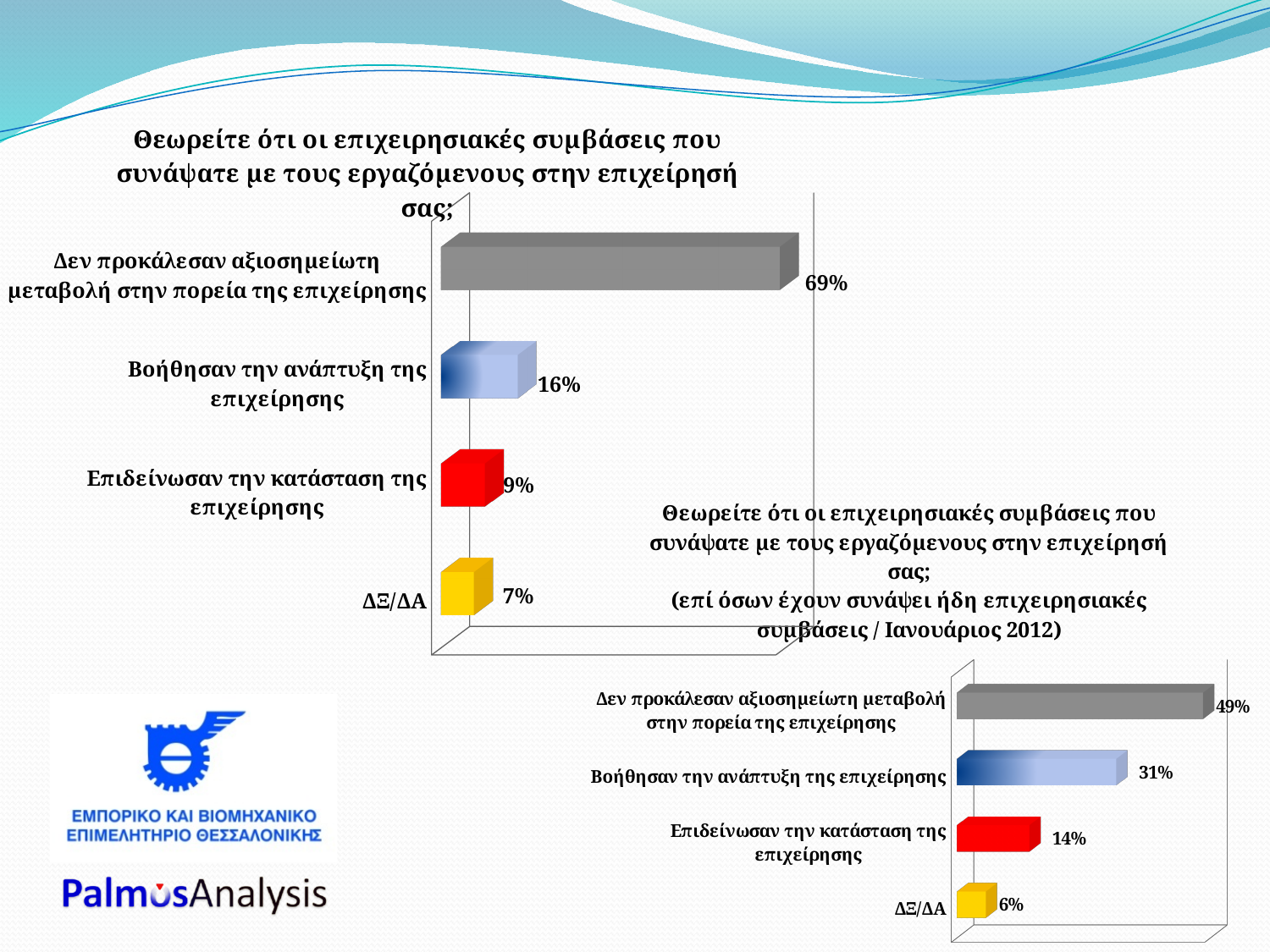
What type of chart is the top-left chart? bar chart In the bottom-right chart, what percentage is shown for 'Επιδείνωσαν την κατάσταση της επιχείρησης'? 14% In the top-left chart, what percentage is shown for 'ΔΞ/ΔΑ'? 7% In the top-left chart, what is the difference between 'Δεν προκάλεσαν αξιοσημείωτη μεταβολή στην πορεία της επιχείρησης' and 'Βοήθησαν την ανάπτυξη της επιχείρησης'? 53% In the bottom-right chart, what is the difference between 'Δεν προκάλεσαν αξιοσημείωτη μεταβολή στην πορεία της επιχείρησης' and 'Βοήθησαν την ανάπτυξη της επιχείρησης'? 18% In the bottom-right chart, which category has the highest value? Δεν προκάλεσαν αξιοσημείωτη μεταβολή στην πορεία της επιχείρησης Which is larger: 'Επιδείνωσαν την κατάσταση της επιχείρησης' in the top-left chart or in the bottom-right chart? bottom-right chart In the bottom-right chart, what percentage is shown for 'Βοήθησαν την ανάπτυξη της επιχείρησης'? 31% In the top-left chart, what percentage is shown for 'Δεν προκάλεσαν αξιοσημείωτη μεταβολή στην πορεία της επιχείρησης'? 69% In the top-left chart, what percentage is shown for 'Βοήθησαν την ανάπτυξη της επιχείρησης'? 16% How many categories does the bottom-right chart show? 4 In the top-left chart, which category has the lowest value? ΔΞ/ΔΑ